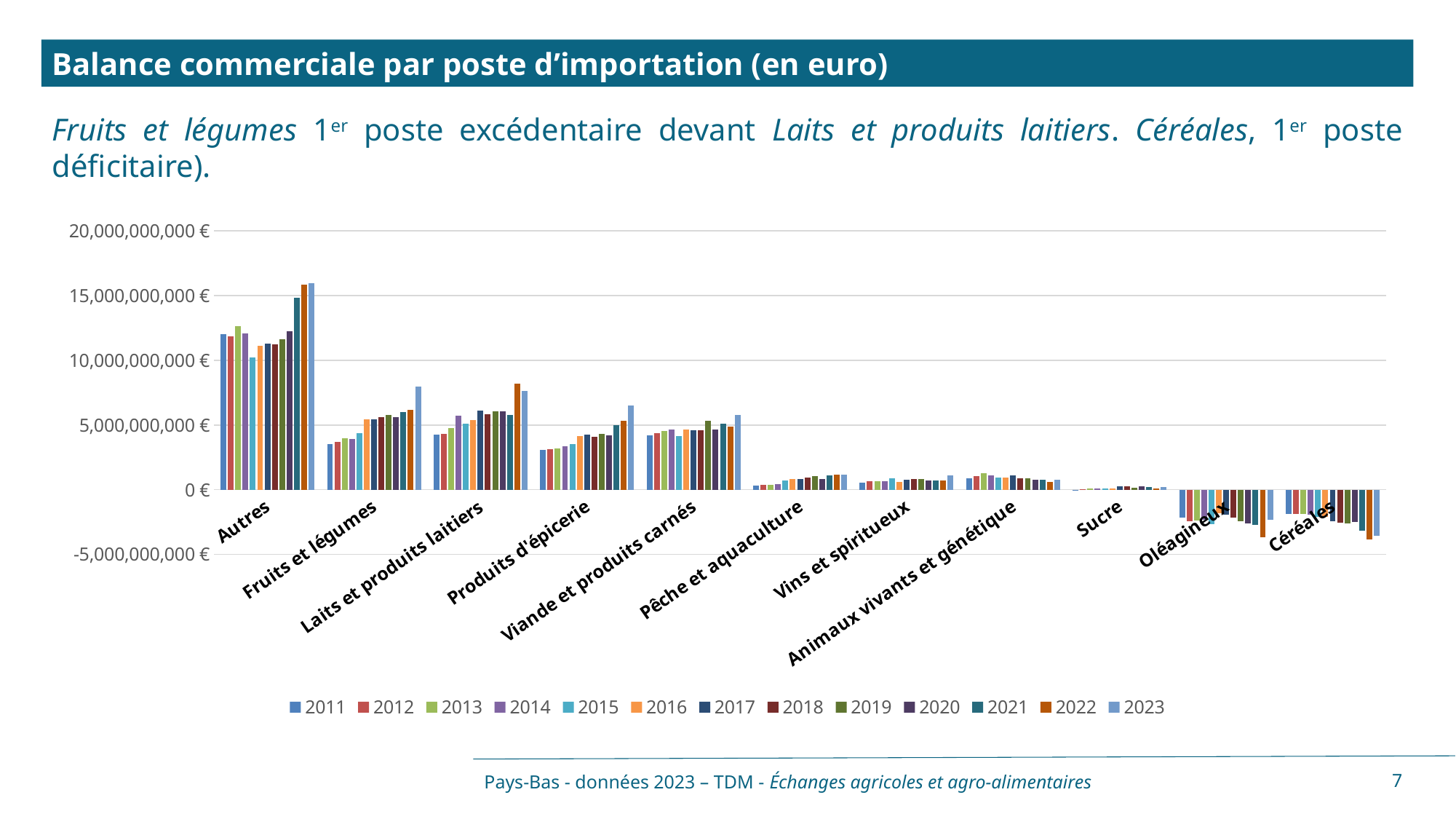
Is the value for Produits d'épicerie in 2011 greater or less than 5,000,000,000 €? less Is the value for Autres in 2023 greater or less than 15,000,000,000 €? greater What kind of chart is shown on the slide? Bar chart How many series (years) does the chart legend list? 13 Which category has the highest bars in the chart? Autres For Fruits et légumes, do the values generally rise or fall from 2011 to 2023? rise How many import categories are shown along the x axis of the chart? 11 Is the value for Fruits et légumes in 2023 greater or less than 5,000,000,000 €? greater Which is larger in 2023: the value for Autres or the value for Fruits et légumes? Autres What is the title of the chart on the slide? Balance commerciale par poste d'importation (en euro) Which category has the lowest (most negative) bars in the chart? Céréales